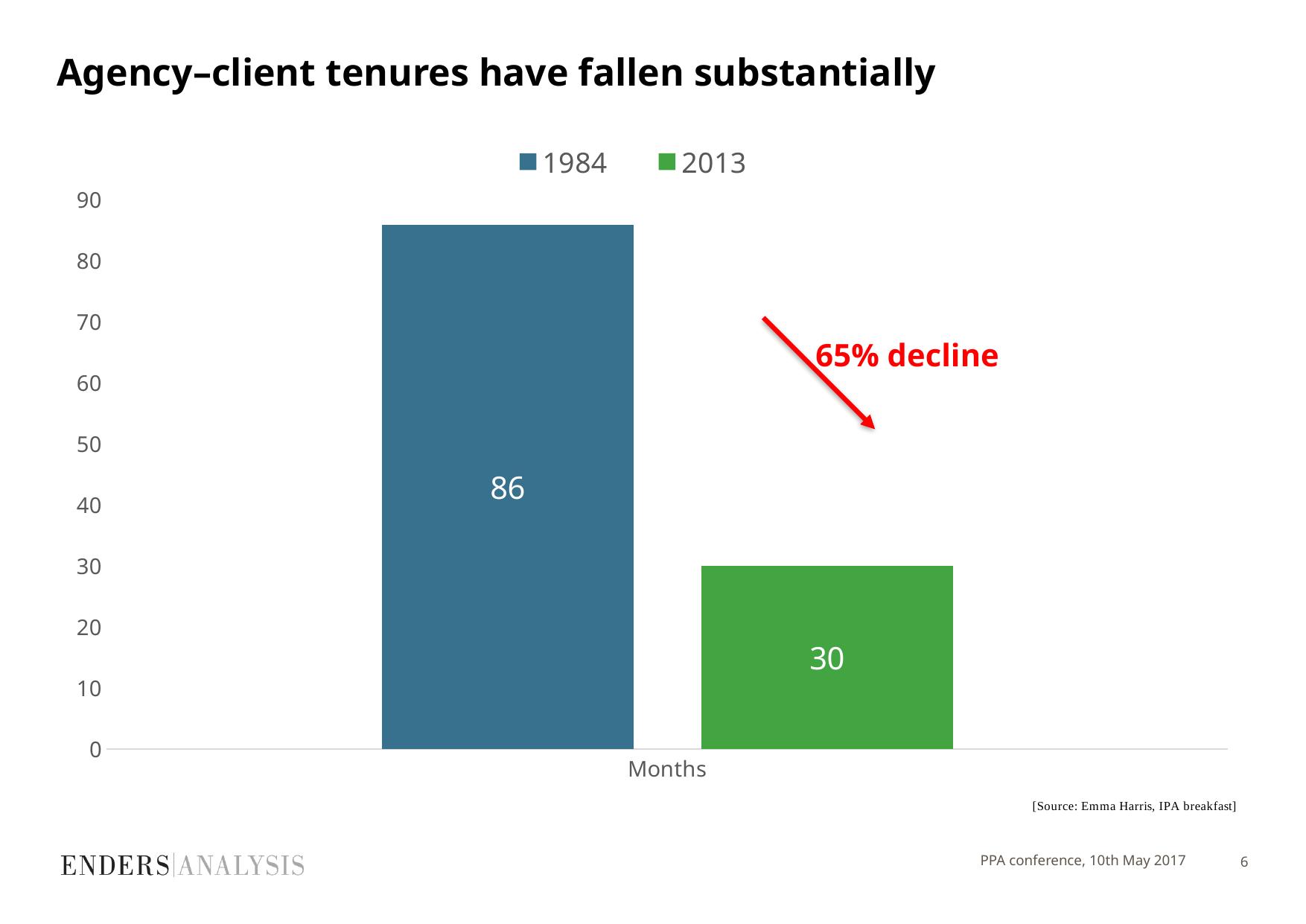
Is the value for 2013 greater or less than 40? less Is the value for 1984 greater or less than 80? greater What is the label on the x axis? Months Which series has the higher value, 1984 or 2013? 1984 What is the difference between the 1984 value and the 2013 value? 56 How many series does the legend list? 2 Which series has the lower value? 2013 What percentage decline is annotated on the chart? 65% What is the value for 1984? 86 What kind of chart is shown on the slide? Bar chart What is the highest value shown on the y axis? 90 What is the value for 2013? 30